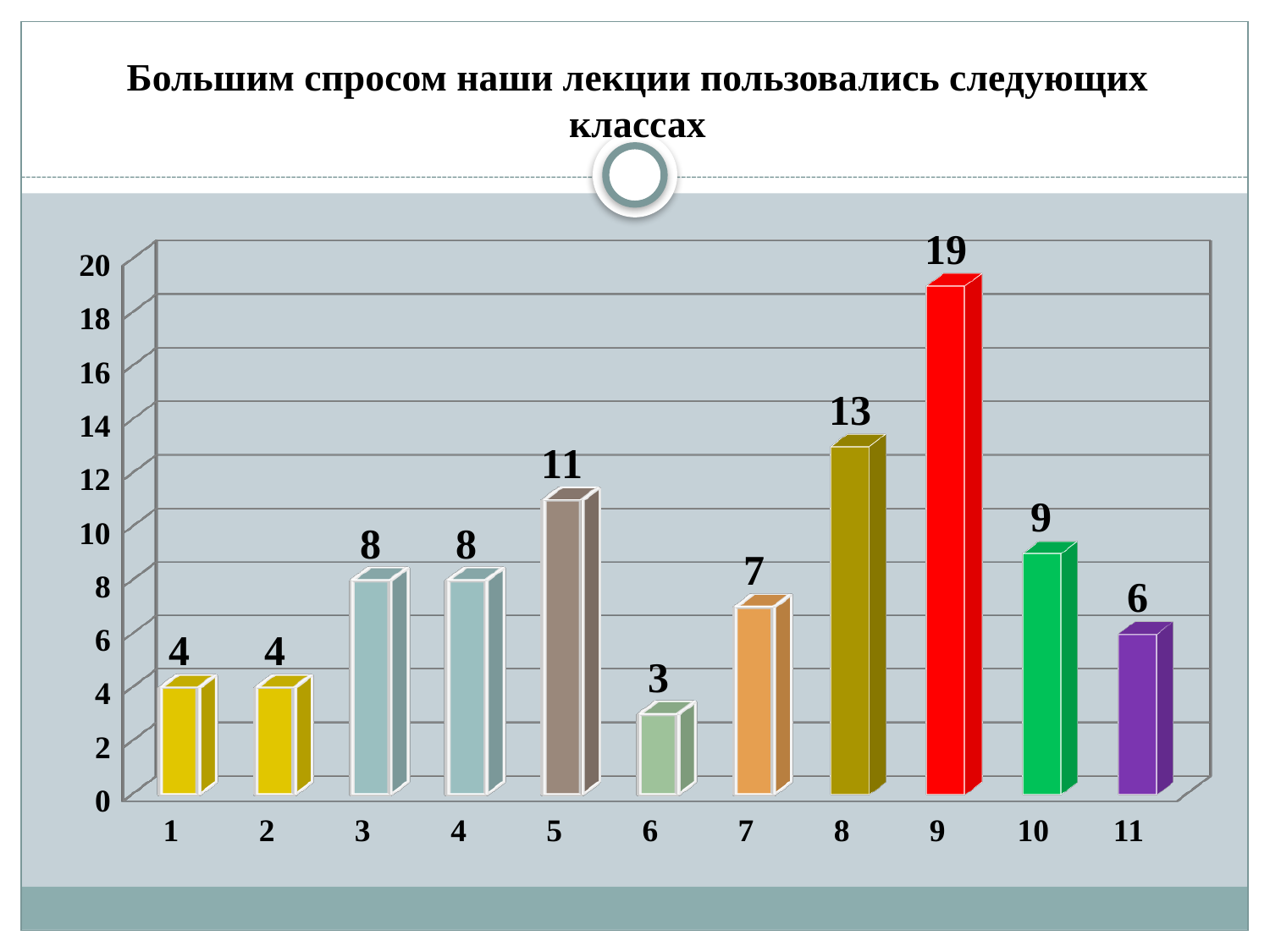
Which category has the highest value? 9 What is the difference between the values for category 9 and category 8? 6 What is the value for category 9? 19 What kind of chart is shown on the slide? bar chart What is the title of the chart? Большим спросом наши лекции пользовались следующих классах What is the value for category 5? 11 How many categories are shown on the x axis? 11 Which category has the lowest value? 6 Which is larger, the value for category 7 or the value for category 10? 10 Is the value for category 8 greater or less than 10? greater What is the value for category 11? 6 What is the difference between the values for category 5 and category 6? 8